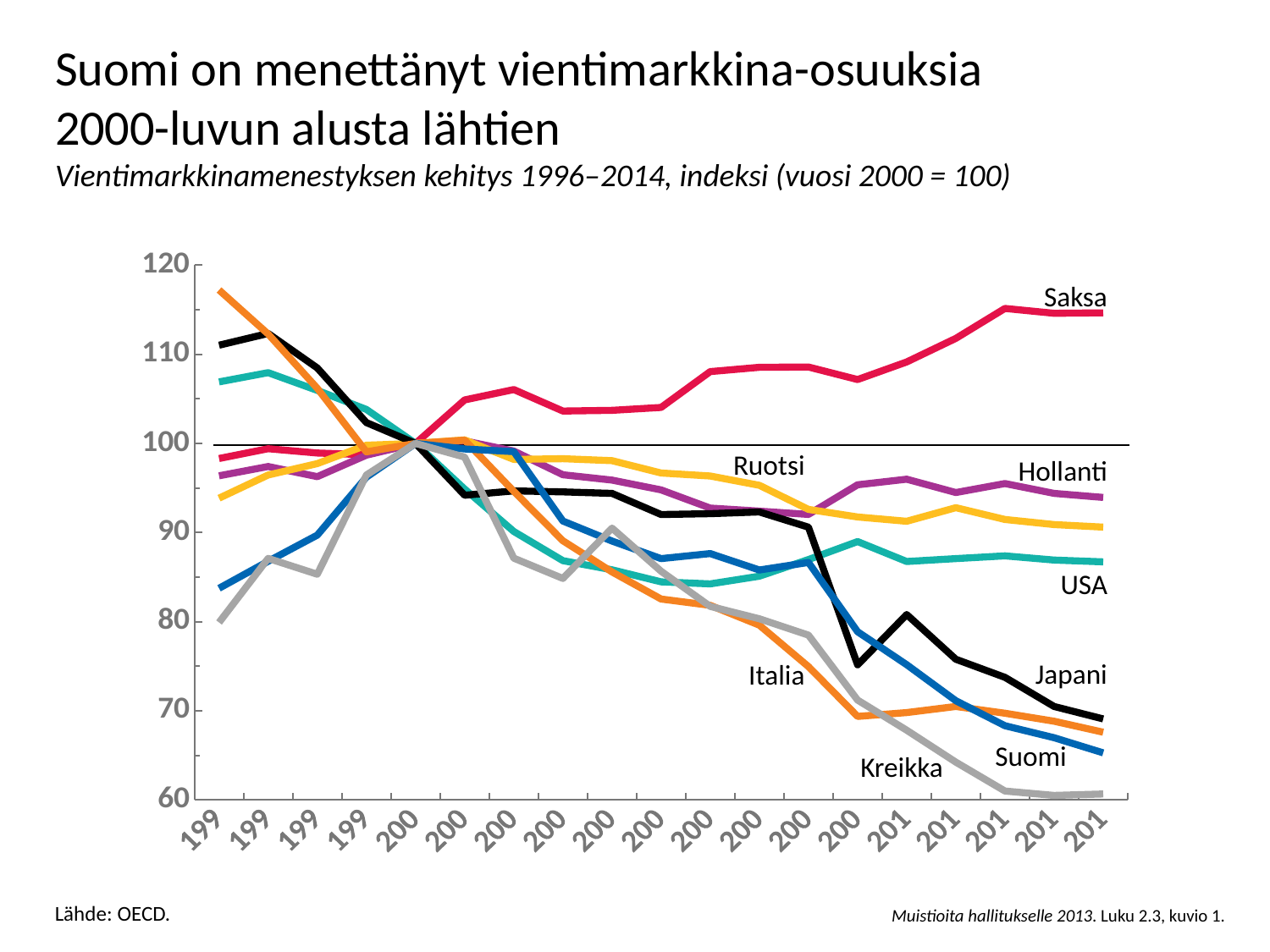
How many country lines are labelled on the chart? 8 Does the line for Suomi rise or fall from 2000 to 2014? fall Is the value for Hollanti in 2014 greater or less than 90? greater Which country has the highest index value at the start of the period (1996)? Italia What kind of chart is shown on the slide? line chart Is the value for Suomi in 2014 greater or less than 70? less Is the value for Saksa in 2014 greater or less than 110? greater What source is cited for the chart? OECD At the end of the period, which is higher: Saksa or USA? Saksa Which country has the highest index value at the end of the period (2014)? Saksa Which country has the lowest index value at the end of the period (2014)? Kreikka What is the index value of every country in the base year 2000? 100